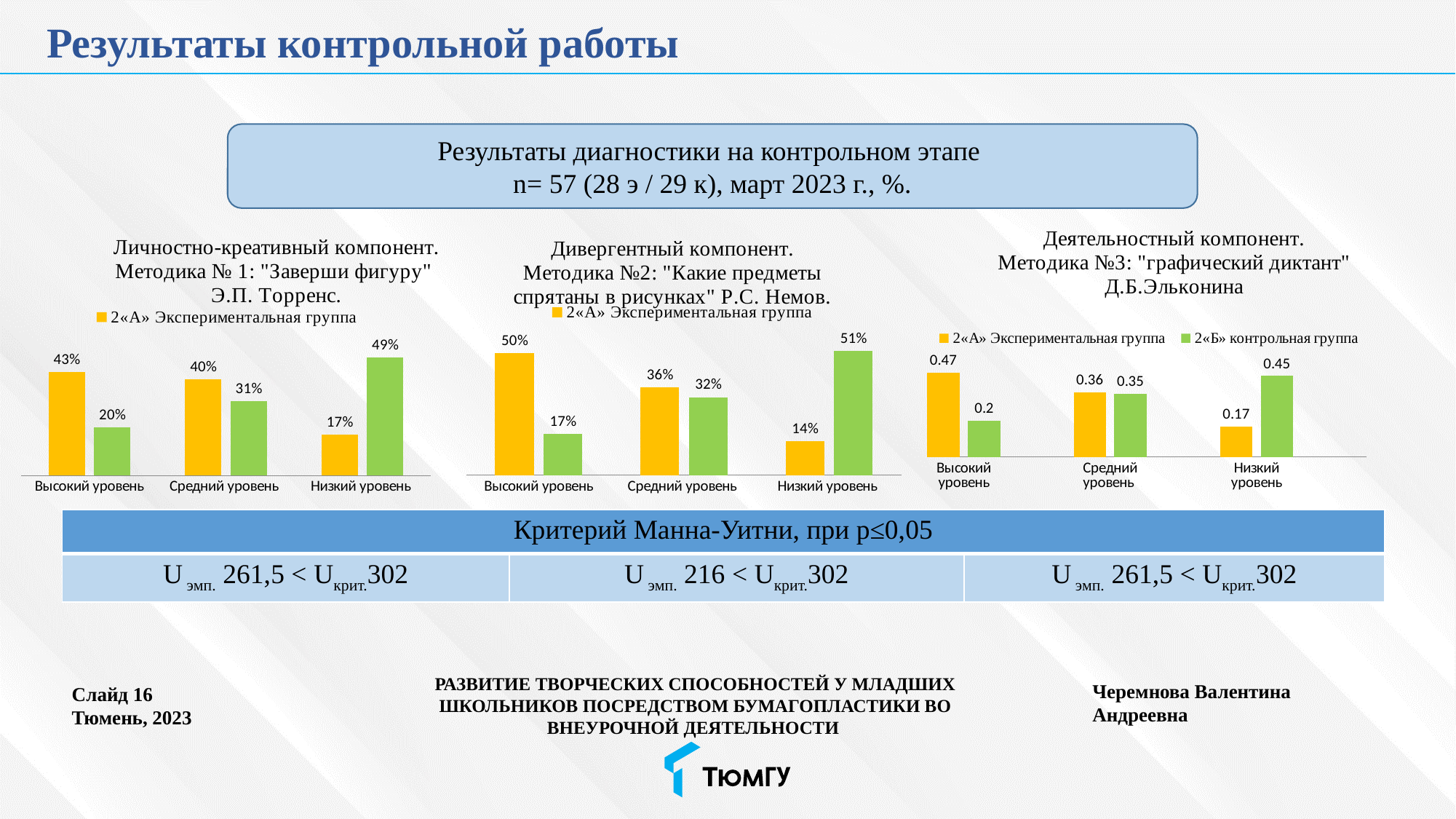
In the middle chart (Методика №2, Немов), what is the value of the 2«А» Экспериментальная группа bar for Высокий уровень? 50% In the left chart (Методика № 1, Торренс), what is the value of the green bar for Низкий уровень? 49% In the right chart (Методика №3, Эльконина), what is the difference between the two groups at Средний уровень? 0.01 In the middle chart (Методика №2, Немов), what is the difference between the yellow and green bars for Высокий уровень? 33% In the middle chart (Методика №2, Немов), which category has the lowest value for the 2«А» Экспериментальная группа? Низкий уровень In the left chart (Методика № 1, Торренс), what is the value of the 2«А» Экспериментальная группа bar for Высокий уровень? 43% How many categories are shown on the x axis of the left chart (Методика № 1, Торренс)? 3 In the right chart (Методика №3, Эльконина), which is larger for Высокий уровень: the 2«А» Экспериментальная группа or the 2«Б» контрольная группа? 2«А» Экспериментальная группа In the right chart (Методика №3, Эльконина), what is the value for the 2«Б» контрольная группа at Низкий уровень? 0.45 How many series does the legend of the right chart (Методика №3, Эльконина) list? 2 In the left chart (Методика № 1, Торренс), what is the difference between the yellow and green bars for Средний уровень? 9% What type of chart is the middle chart (Методика №2, Немов)? Bar chart